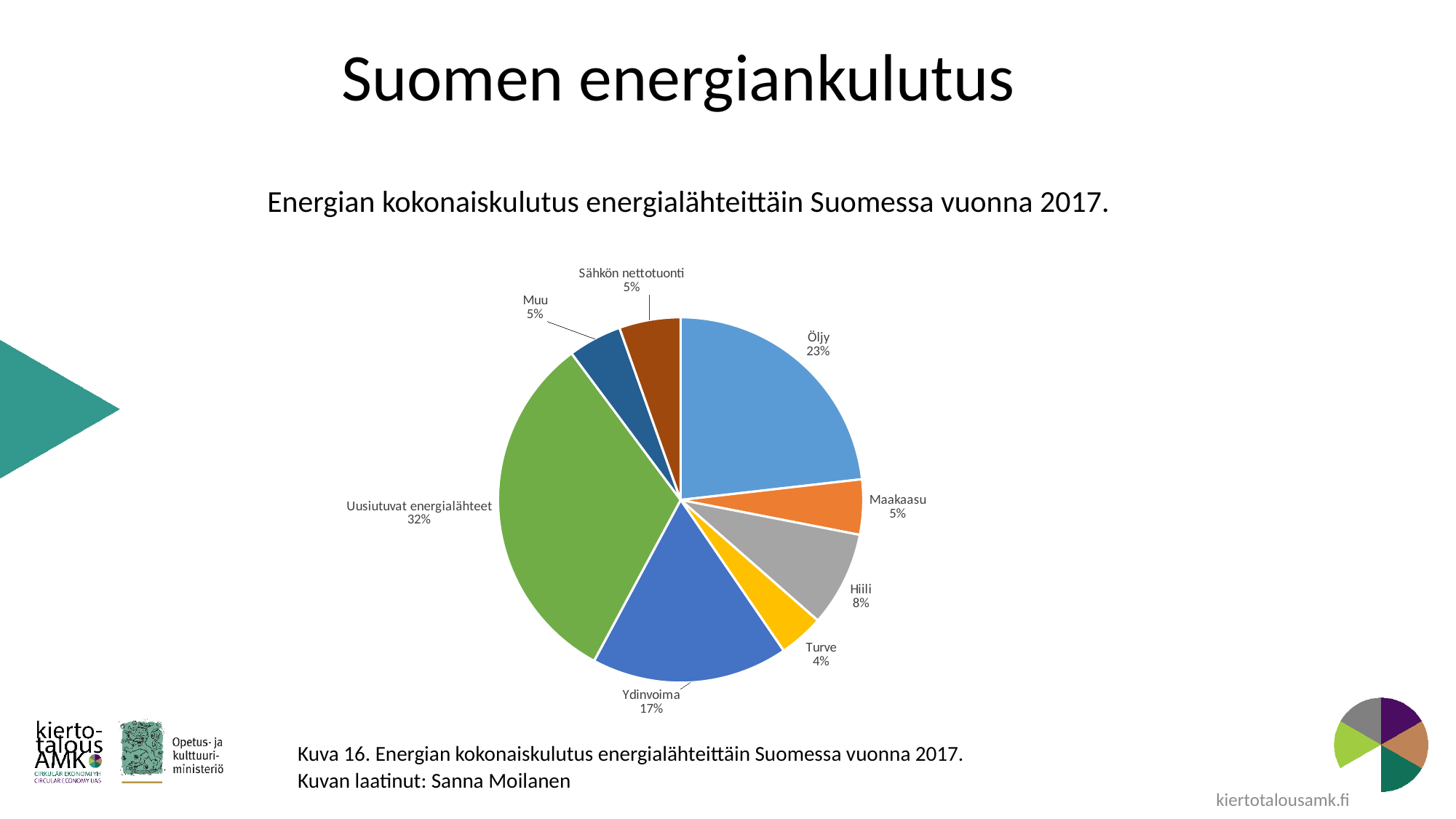
Which energy source has the smallest slice of the pie? Turve What is the difference in percentage points between Uusiutuvat energialähteet and Öljy? 9 Which energy source has the largest slice of the pie? Uusiutuvat energialähteet What percentage is shown for Hiili? 8% What percentage is shown for Uusiutuvat energialähteet? 32% What is the title of the pie chart? Energian kokonaiskulutus energialähteittäin Suomessa vuonna 2017. What share of Finland's total energy consumption in 2017 does Öljy account for? 23% What type of chart is shown on the slide? pie chart Which is larger, the share for Ydinvoima or the share for Hiili? Ydinvoima How many slices does the pie chart have? 8 What percentage is shown for Turve? 4% What percentage is shown for Ydinvoima? 17%